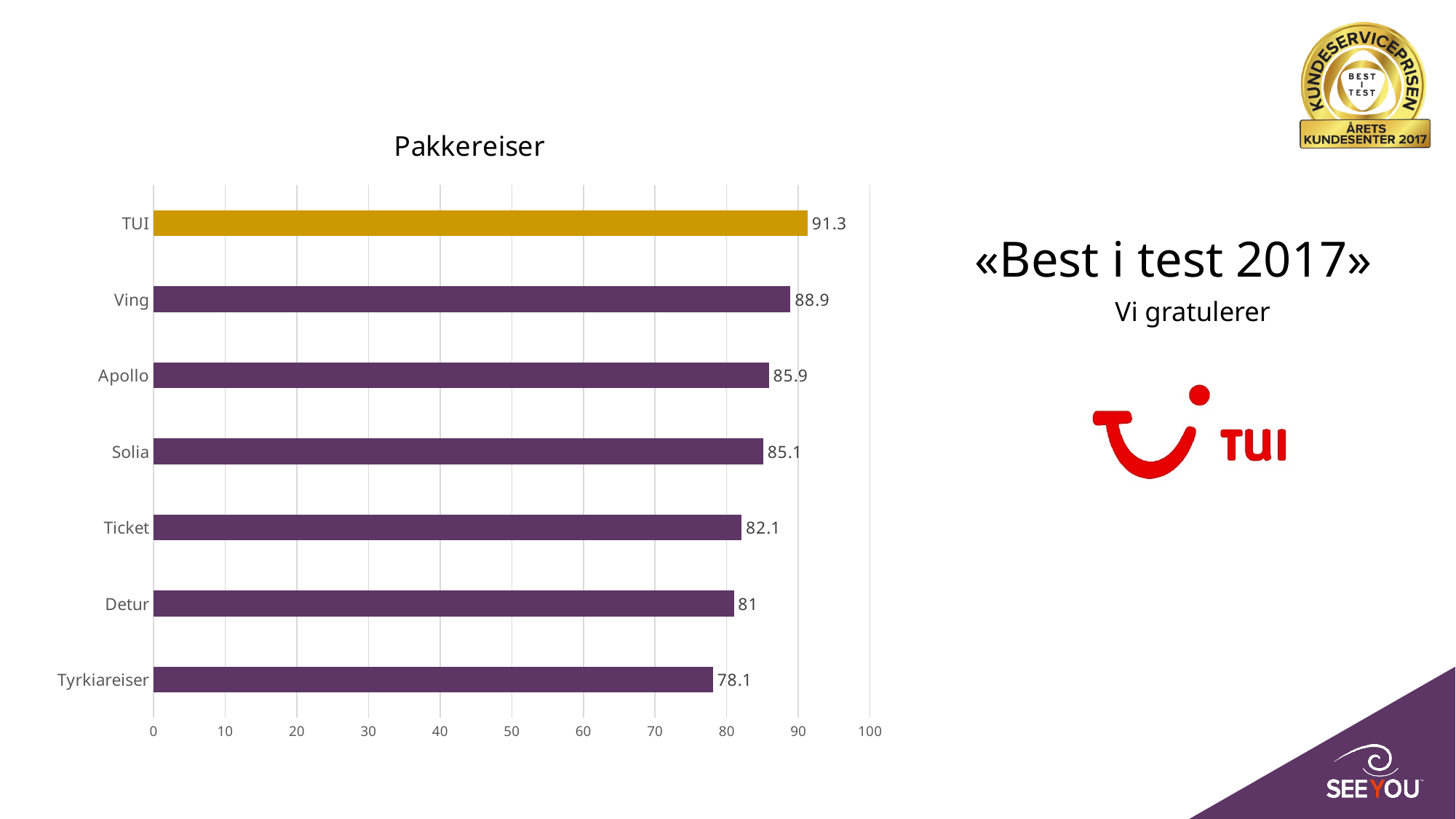
What is the value for Detur? 81 What kind of chart is shown on the slide? bar chart What is the value for Solia? 85.1 What is the difference between the values for Ticket and Tyrkiareiser? 4 How many categories are shown in the chart? 7 Which category has the highest value? TUI What is the title of the chart? Pakkereiser What is the value for TUI? 91.3 Which is larger, the value for Apollo or the value for Ticket? Apollo Is the value for Tyrkiareiser greater or less than 80? less What is the difference between the values for TUI and Ving? 2.4 Which category has the lowest value? Tyrkiareiser